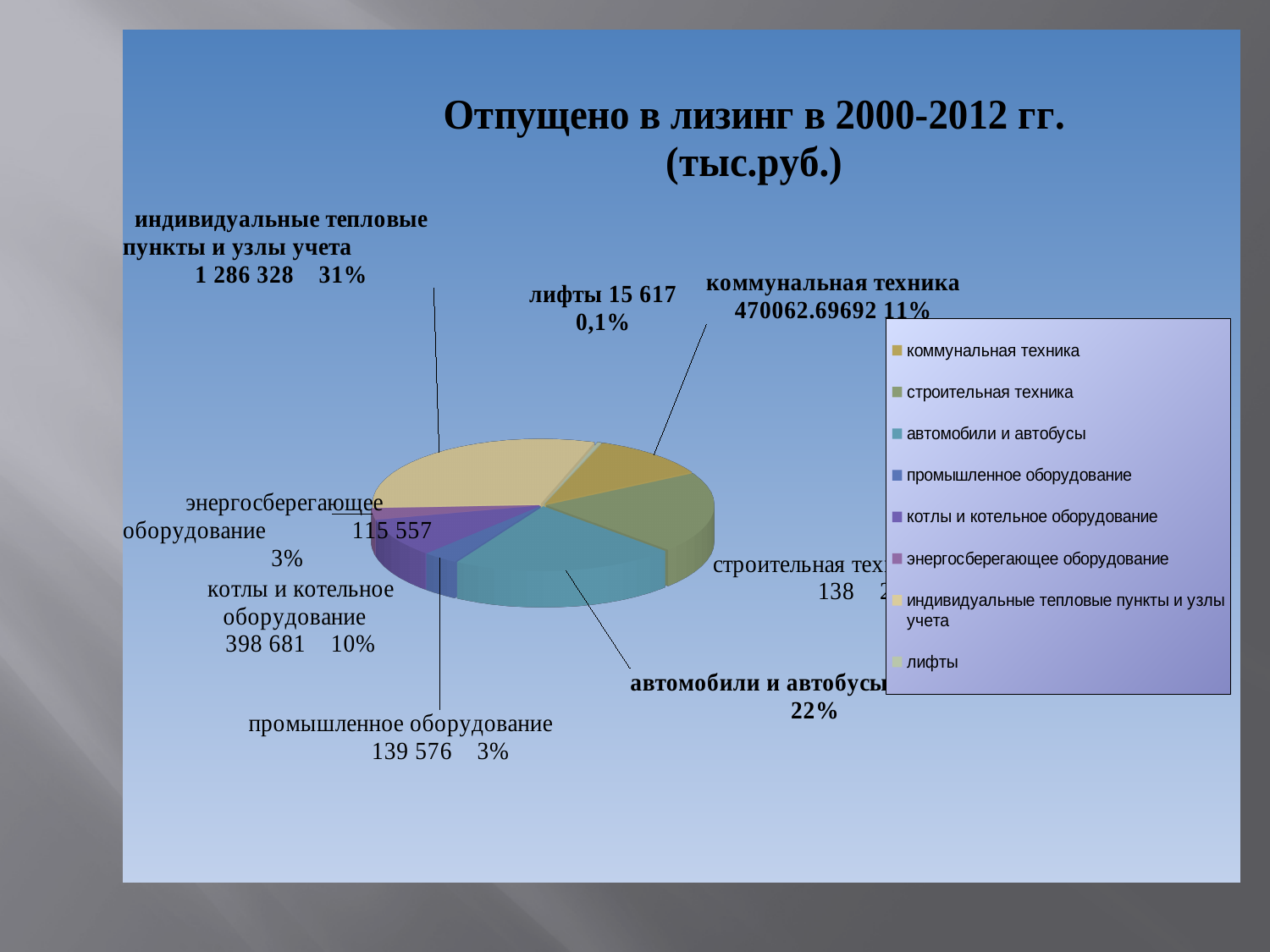
Which category has the largest share of the pie? индивидуальные тепловые пункты и узлы учета Which category has the smallest share of the pie? лифты What is the difference between the values for котлы и котельное оборудование and промышленное оборудование? 259 105 What kind of chart is shown on the slide? pie chart What is the value for котлы и котельное оборудование? 398 681 How many categories does the legend list? 8 What is the value for индивидуальные тепловые пункты и узлы учета? 1 286 328 What is the value for промышленное оборудование? 139 576 What is the title of the chart? Отпущено в лизинг в 2000-2012 гг. (тыс.руб.) What share of the pie does автомобили и автобусы take? 22% What is the value for энергосберегающее оборудование? 115 557 What share of the pie does коммунальная техника take? 11%